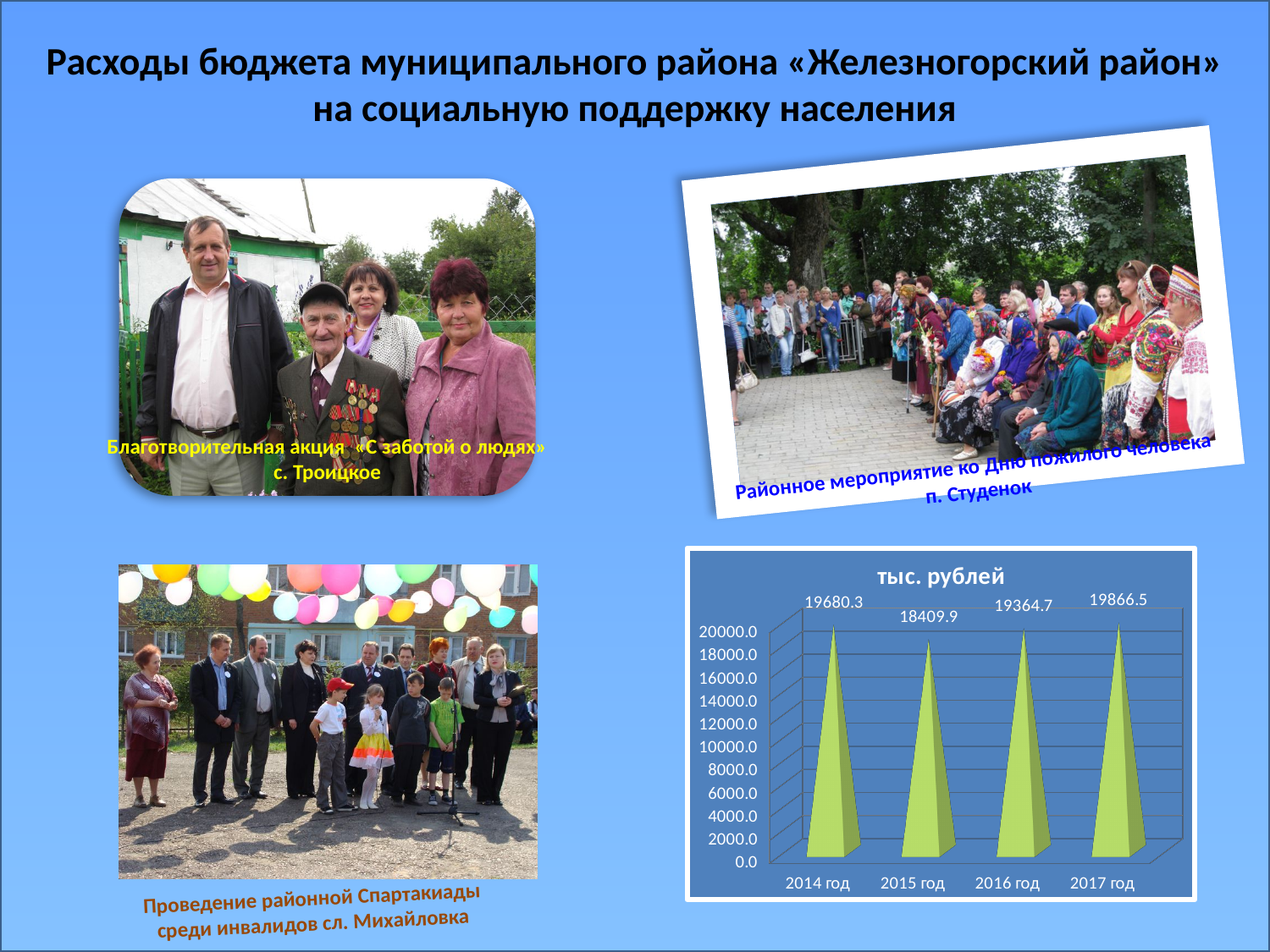
From 2015 год to 2017 год, do the values rise or fall? rise What is the value for 2016 год in the chart? 19364.7 What is the value for 2014 год in the chart titled «тыс. рублей»? 19680.3 What kind of chart is shown on the slide? bar chart Which year has the highest value in the chart? 2017 год Which is larger, the value for 2016 год or the value for 2015 год? 2016 год How many years are shown on the x axis of the chart? 4 What is the value for 2017 год in the chart? 19866.5 What is the difference between the values for 2017 год and 2016 год? 501.8 What is the value for 2015 год in the chart? 18409.9 What is the difference between the values for 2014 год and 2015 год? 1270.4 Which year has the lowest value in the chart? 2015 год